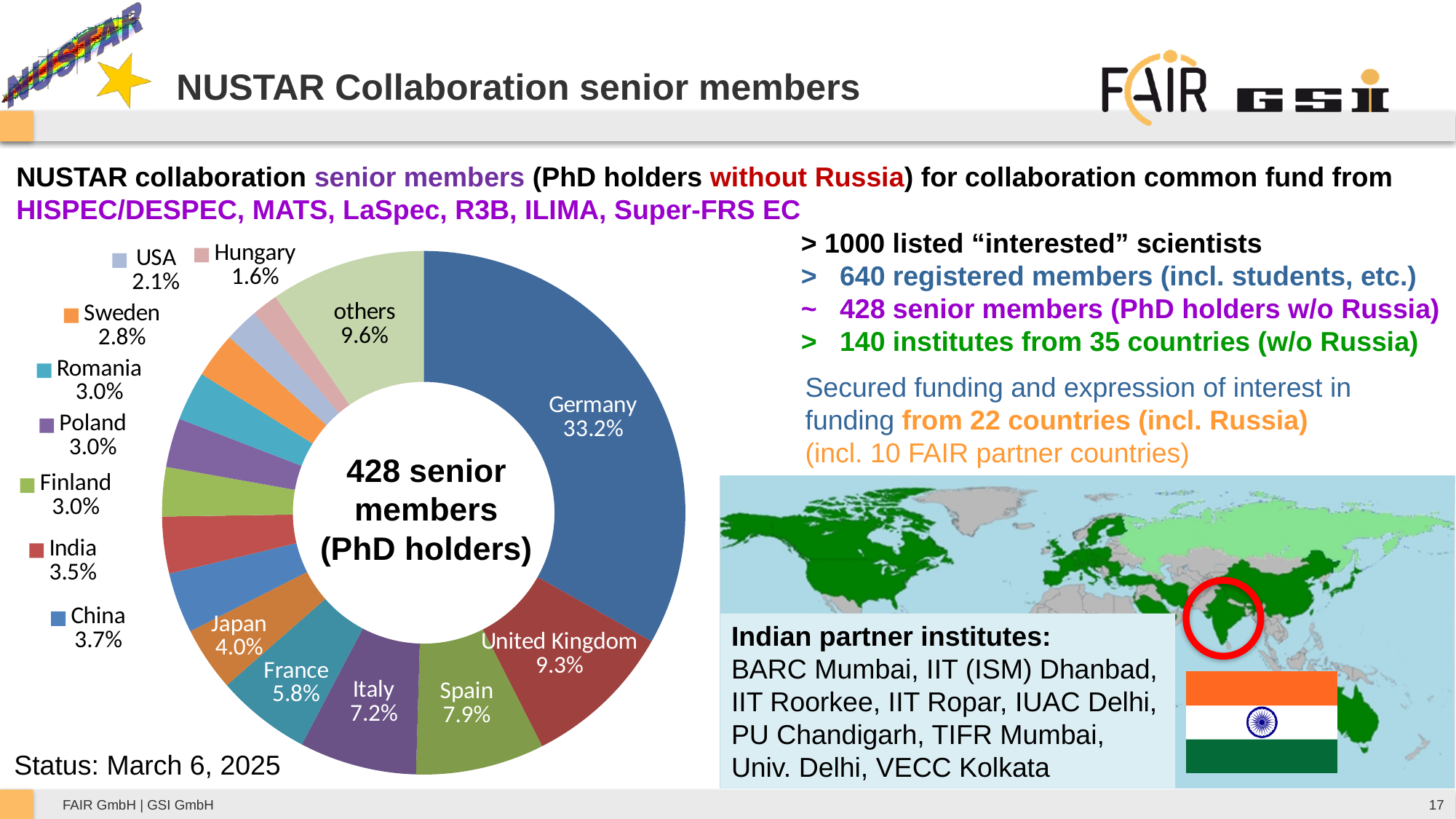
Which has a larger share of senior members, Italy or Japan? Italy What percentage of senior members is from France? 5.8% What share of the senior members is from Germany? 33.2% What percentage of senior members is from the United Kingdom? 9.3% What text is written in the centre of the donut chart? 428 senior members (PhD holders) Which named country has the smallest share of senior members? Hungary How many slices does the pie chart have, including 'others'? 15 What kind of chart is shown on the slide? Pie chart (donut) What is the difference in percentage points between Germany's share and the United Kingdom's share? 23.9 Which country has the largest share of senior members? Germany What percentage of senior members is from Spain? 7.9% What is the share of the 'others' slice? 9.6%